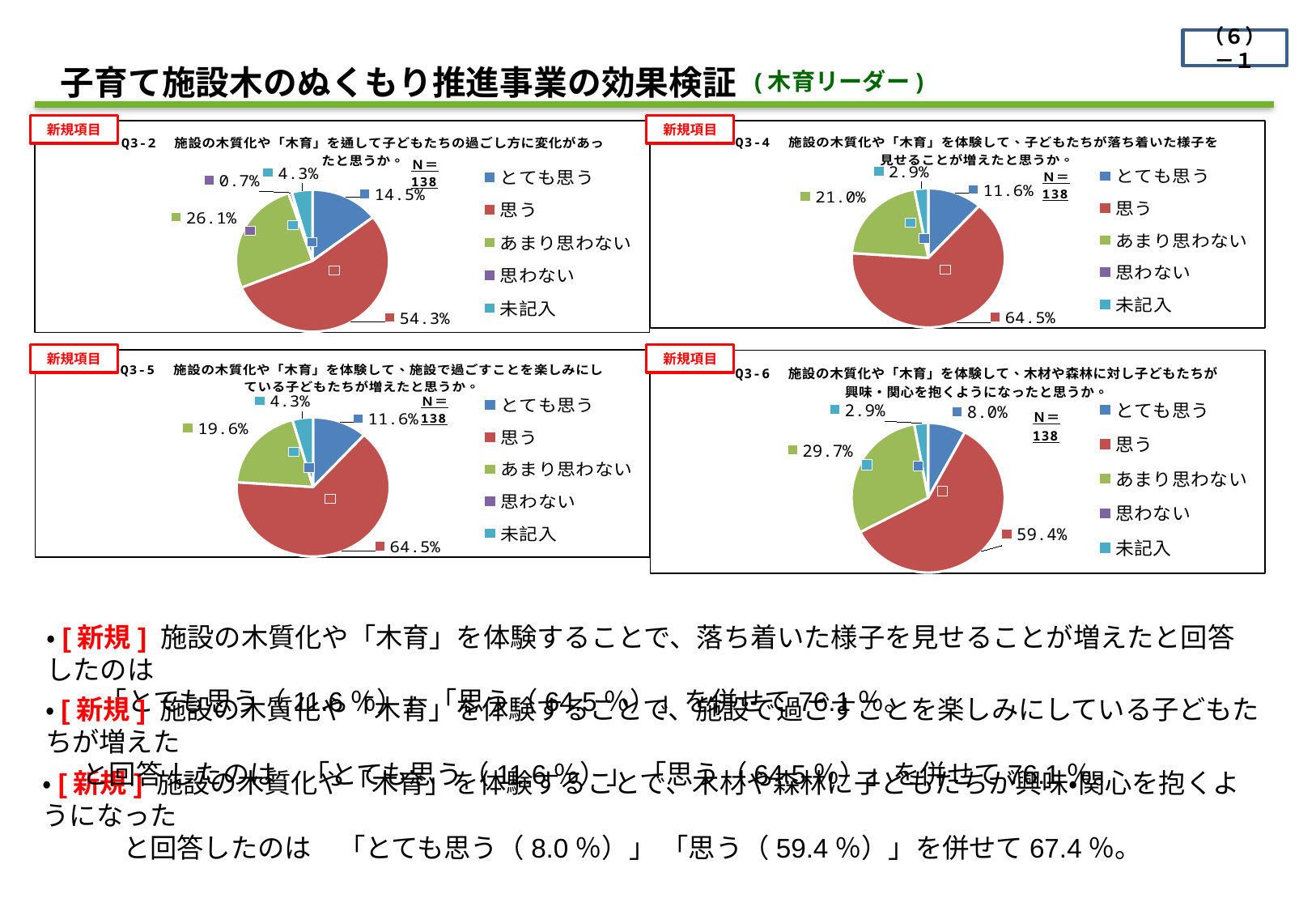
In the Q3-5 pie chart, which is larger: the share for 「あまり思わない」 or the share for 「とても思う」? あまり思わない How many entries does the legend of the Q3-6 pie chart list? 5 In the Q3-2 pie chart, what percentage is shown for 「思う」? 54.3% What is the sample size (N) shown for the Q3-2 chart? 138 In the Q3-4 pie chart, what is the combined share of 「とても思う」 and 「思う」? 76.1% In the Q3-6 pie chart, what is the difference between the shares for 「思う」 and 「あまり思わない」? 29.7% In the Q3-5 pie chart, which category has the largest share? 思う In the Q3-4 pie chart, what percentage is shown for 「あまり思わない」? 21.0% In the Q3-6 pie chart, what percentage is shown for 「とても思う」? 8.0% In the Q3-2 pie chart, which labeled category has the smallest share? 思わない What type of chart is used for Q3-4? Pie chart In the Q3-2 pie chart, what percentage is shown for 「思わない」? 0.7%